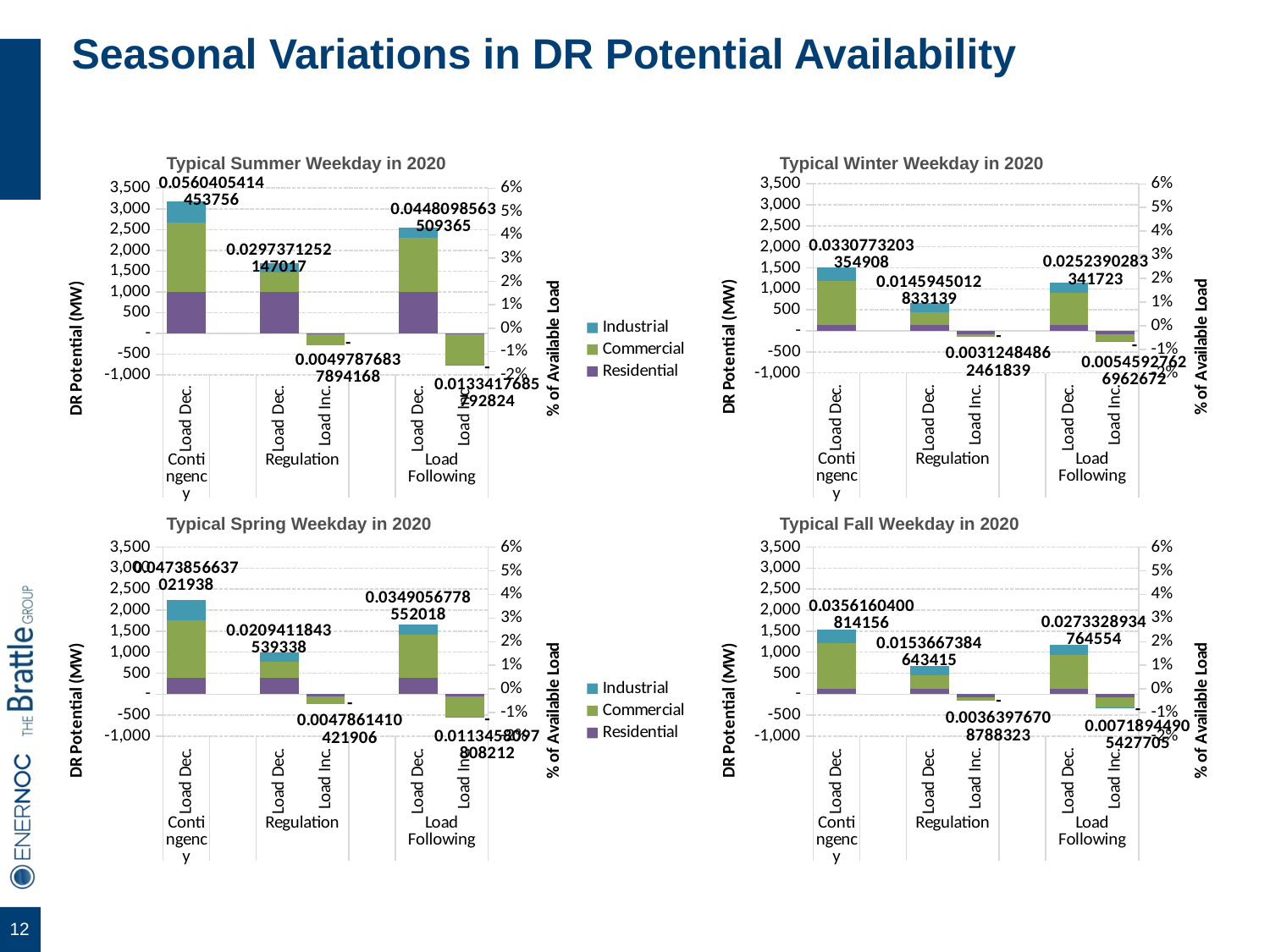
In the Typical Summer Weekday in 2020 chart, which bar extends furthest below zero? Load Following Load Inc. In the Typical Winter Weekday in 2020 chart, is the total for the Contingency Load Dec. bar greater or less than 1,000? greater In the Typical Fall Weekday in 2020 chart, which is taller: the Regulation Load Dec. bar or the Load Following Load Dec. bar? Load Following Load Dec. How many bars are plotted in the Typical Fall Weekday in 2020 chart? 5 In the Typical Spring Weekday in 2020 chart, is the total for the Contingency Load Dec. bar greater or less than 2,000? greater What is the label on the left vertical axis of the Typical Winter Weekday in 2020 chart? DR Potential (MW) Which series are listed in the legend of the Typical Spring Weekday in 2020 chart? Industrial, Commercial, Residential Which chart has the taller Contingency Load Dec. bar: Typical Summer Weekday in 2020 or Typical Winter Weekday in 2020? Typical Summer Weekday in 2020 What kind of chart is the Typical Summer Weekday in 2020 chart? bar chart In the Typical Summer Weekday in 2020 chart, is the total for the Contingency Load Dec. bar greater or less than 3,000? greater In the Typical Summer Weekday in 2020 chart, which bar is the tallest? Contingency Load Dec.